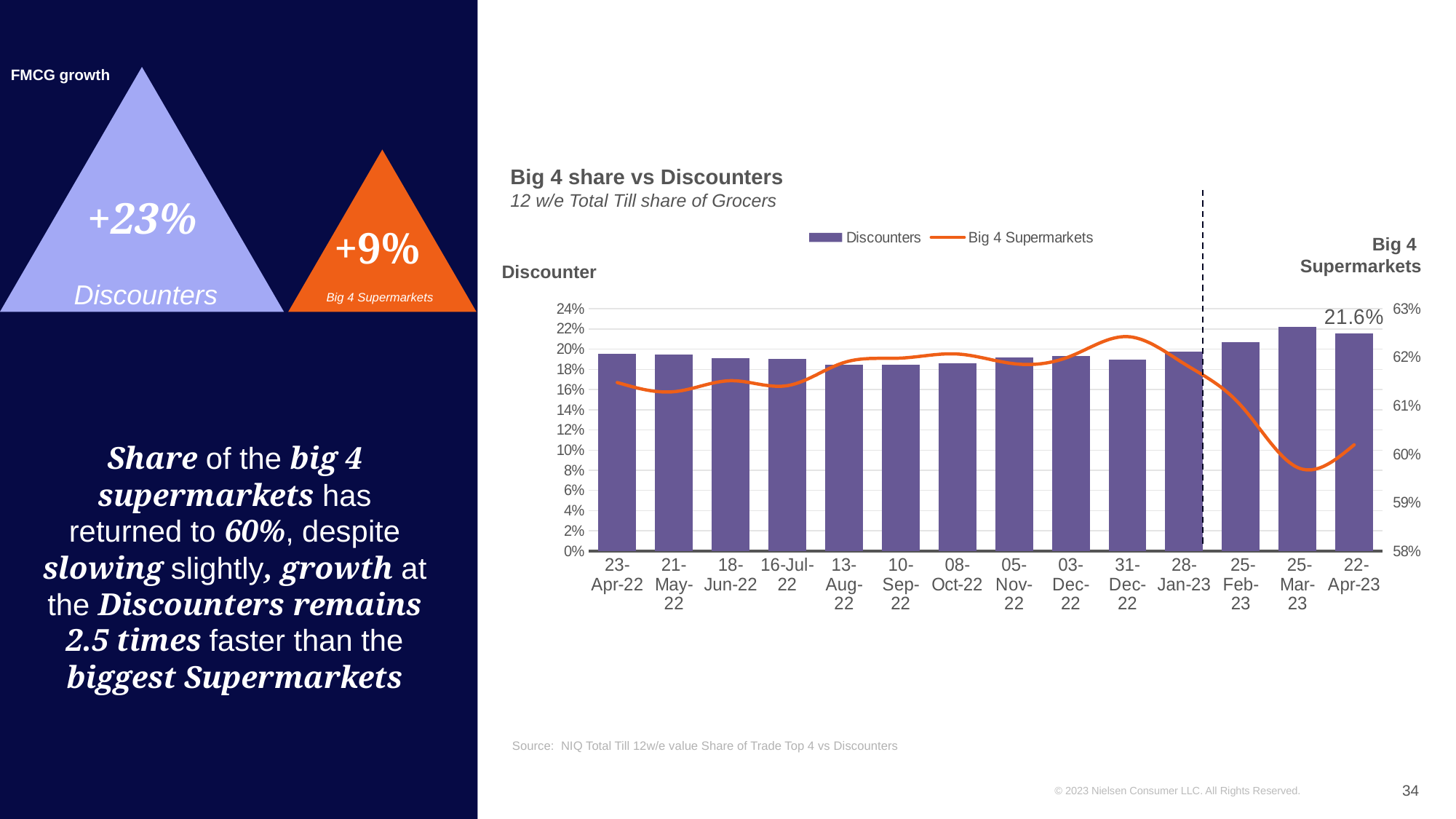
How many series does the chart legend list? 2 How many time periods are shown on the x axis of the chart? 14 Is the Big 4 Supermarkets value for 25-Mar-23 greater or less than 60%? less Does the Big 4 Supermarkets line rise or fall between 31-Dec-22 and 25-Mar-23? fall What kind of chart is used for the Discounters series? Bar chart Which is larger, the Discounters value for 25-Feb-23 or for 10-Sep-22? 25-Feb-23 What is the Discounters share shown for 22-Apr-23? 21.6% Is the Discounters value for 10-Sep-22 greater or less than 20%? less What is the subtitle of the chart? 12 w/e Total Till share of Grocers Is the Big 4 Supermarkets value for 31-Dec-22 greater or less than 62%? greater Which series is drawn as a line in the chart? Big 4 Supermarkets